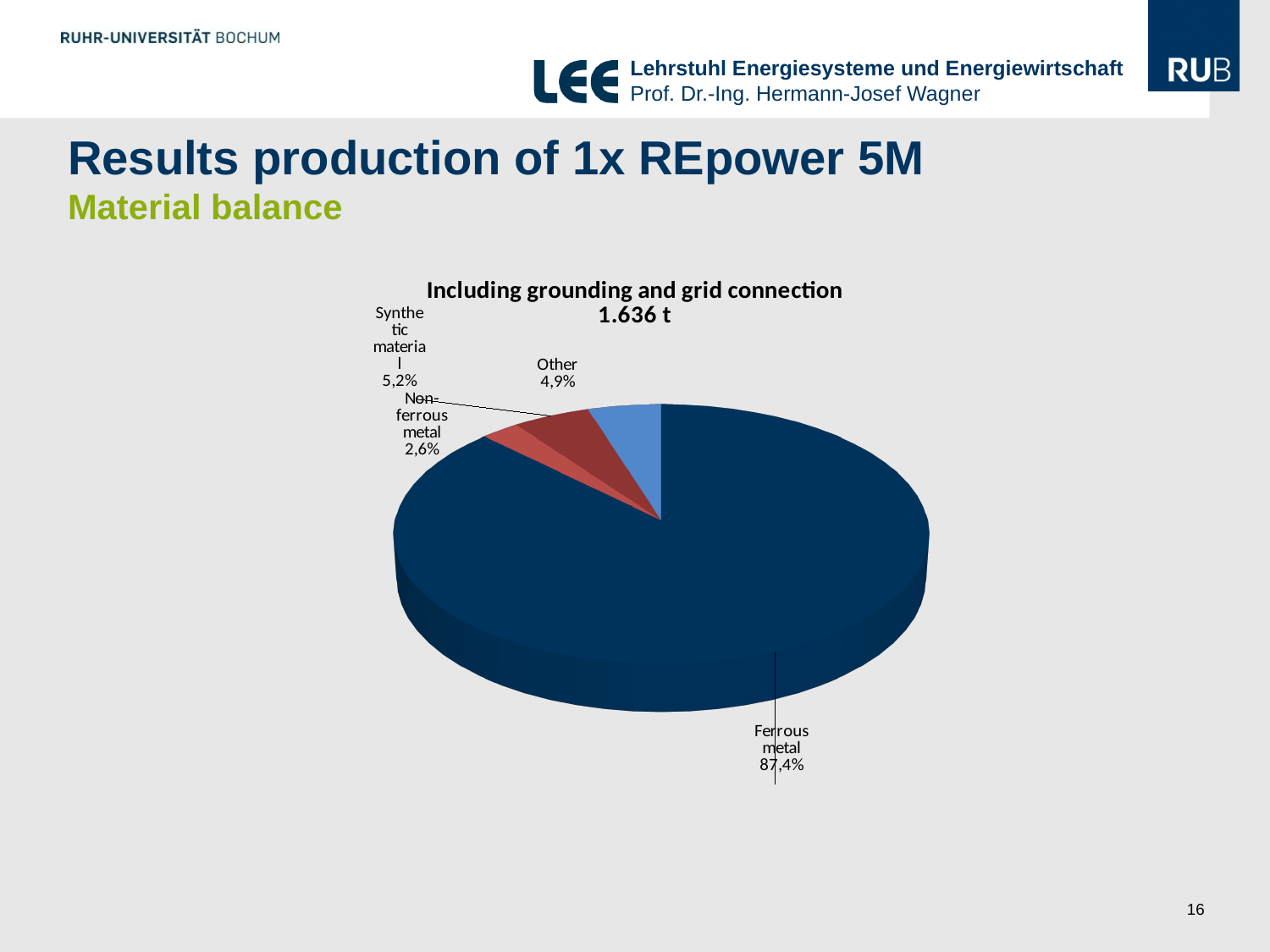
What is the share of Synthetic material in the pie chart? 5,2% What is the difference in percentage points between the Ferrous metal share and the Synthetic material share? 82,2 What type of chart is shown on the slide? pie chart Which has a larger share, Synthetic material or Other? Synthetic material Which category has the largest share of the pie? Ferrous metal What total mass is stated in the chart title? 1.636 t What is the share of Non-ferrous metal in the pie chart? 2,6% What is the title of the pie chart? Including grounding and grid connection 1.636 t What is the share of Other in the pie chart? 4,9% Which category has the smallest share of the pie? Non-ferrous metal What is the share of Ferrous metal in the pie chart? 87,4% How many slices does the pie chart have? 4